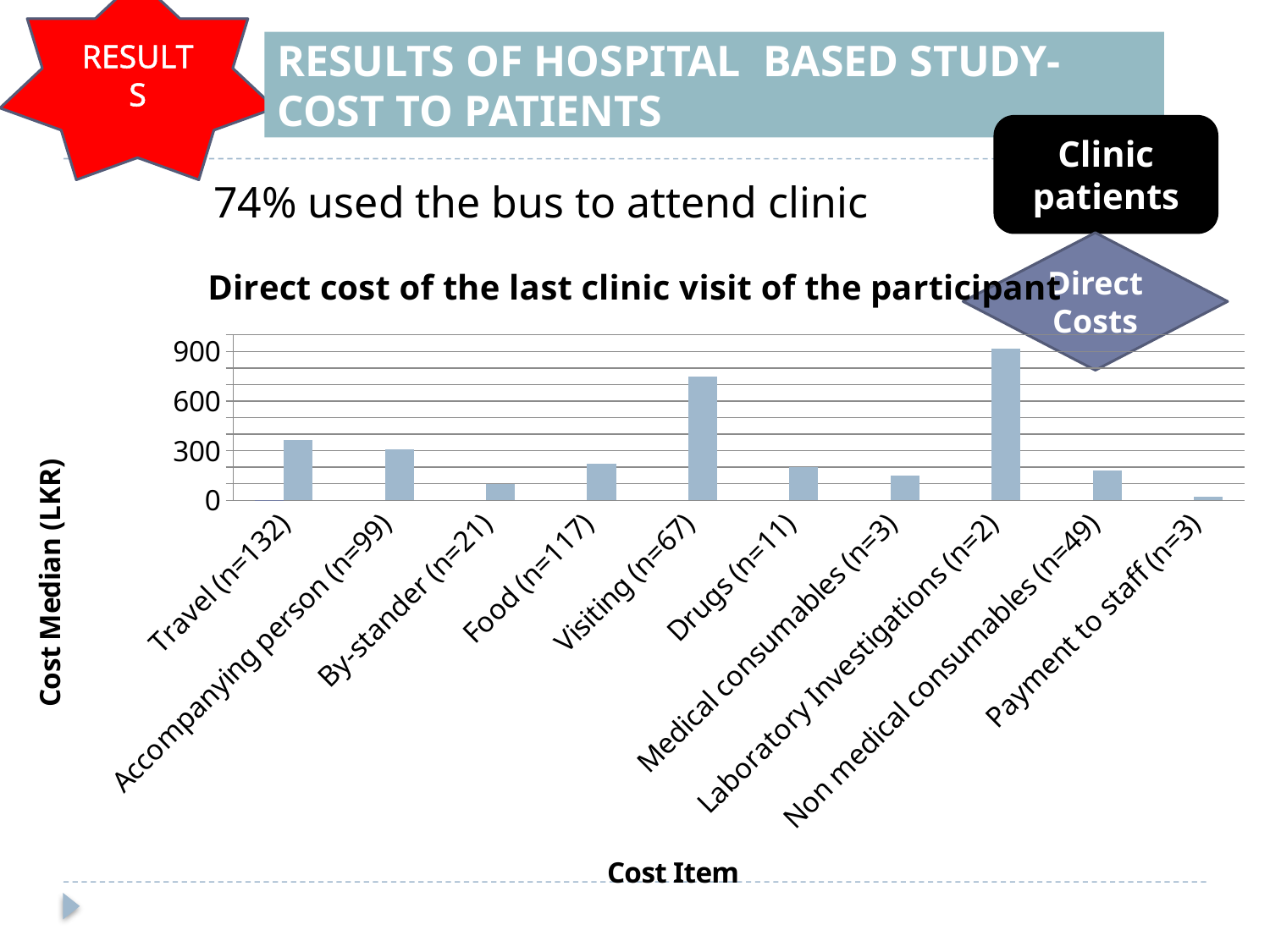
Is the value for By-stander (n=21) greater or less than 300? less Which cost item has the lowest median cost? Payment to staff (n=3) Is the value for Visiting (n=67) greater or less than 600? greater How many cost items are plotted on the chart? 10 Is the value for Food (n=117) greater or less than 300? less What is the title of the chart? Direct cost of the last clinic visit of the participant Which has a higher median cost, Travel (n=132) or Food (n=117)? Travel (n=132) Which cost item has the highest median cost? Laboratory Investigations (n=2) What kind of chart is shown on the slide? bar chart What is the label of the vertical axis? Cost Median (LKR) Which has a higher median cost, Visiting (n=67) or Travel (n=132)? Visiting (n=67)